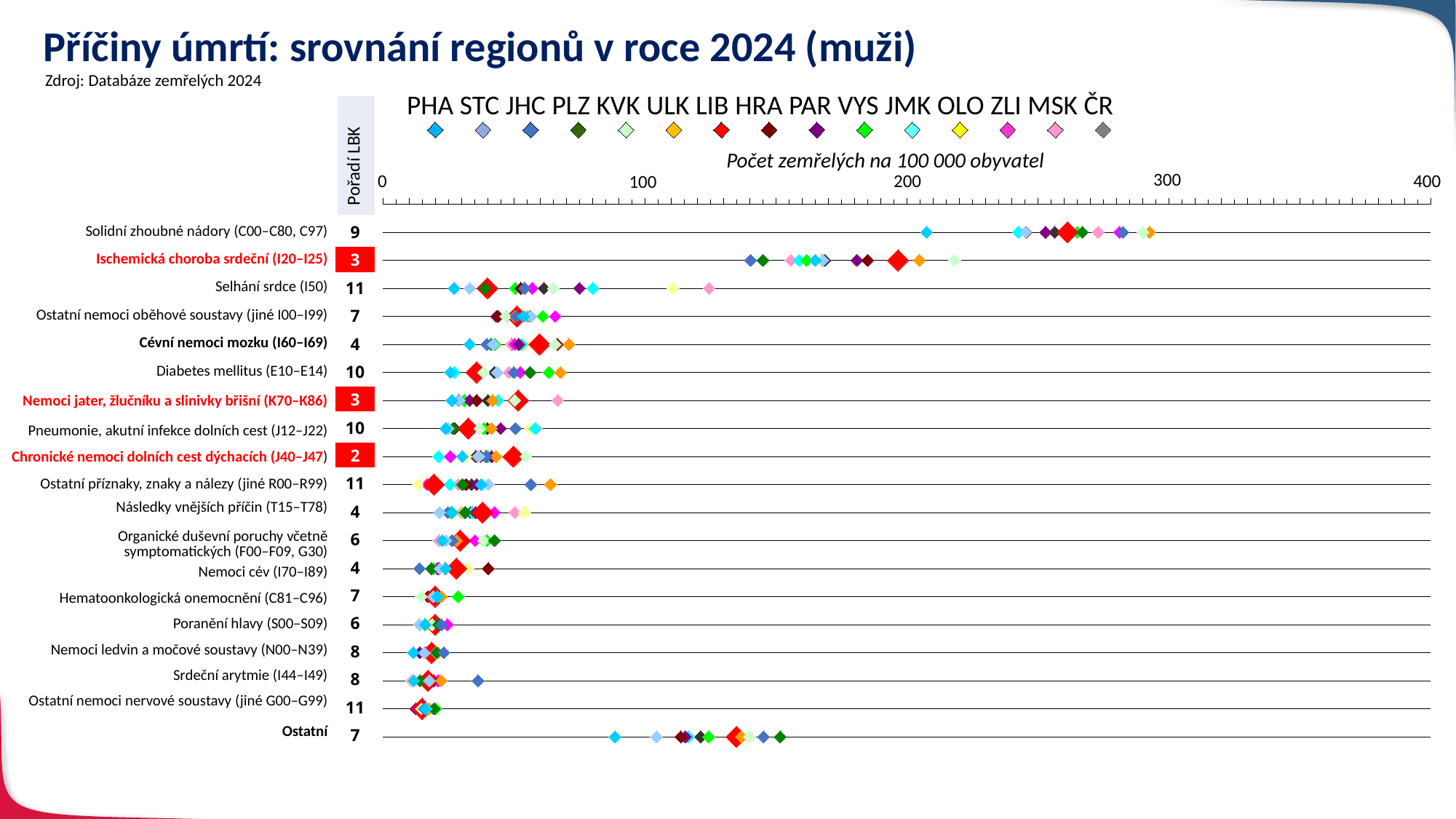
Which cause of death has the highest values across the regions? Solidní zhoubné nádory (C00–C80, C97) For LIB, which is larger: the value for Solidní zhoubné nádory (C00–C80, C97) or for Ischemická choroba srdeční (I20–I25)? Solidní zhoubné nádory (C00–C80, C97) How many series does the legend list? 15 What kind of chart is shown on the slide? scatter (dot) chart What is the LBK rank (Pořadí LBK) shown for Ischemická choroba srdeční (I20–I25)? 3 Is the value for LIB in Solidní zhoubné nádory (C00–C80, C97) greater or less than 200? greater What is the label of the horizontal axis of the chart? Počet zemřelých na 100 000 obyvatel Is the value for LIB in Selhání srdce (I50) greater or less than 100? less What is the LBK rank (Pořadí LBK) shown for Solidní zhoubné nádory (C00–C80, C97)? 9 How many causes of death (categories) are plotted on the chart? 19 What is the LBK rank (Pořadí LBK) shown for Chronické nemoci dolních cest dýchacích (J40–J47)? 2 Is the value for PHA in Solidní zhoubné nádory (C00–C80, C97) greater or less than 300? less